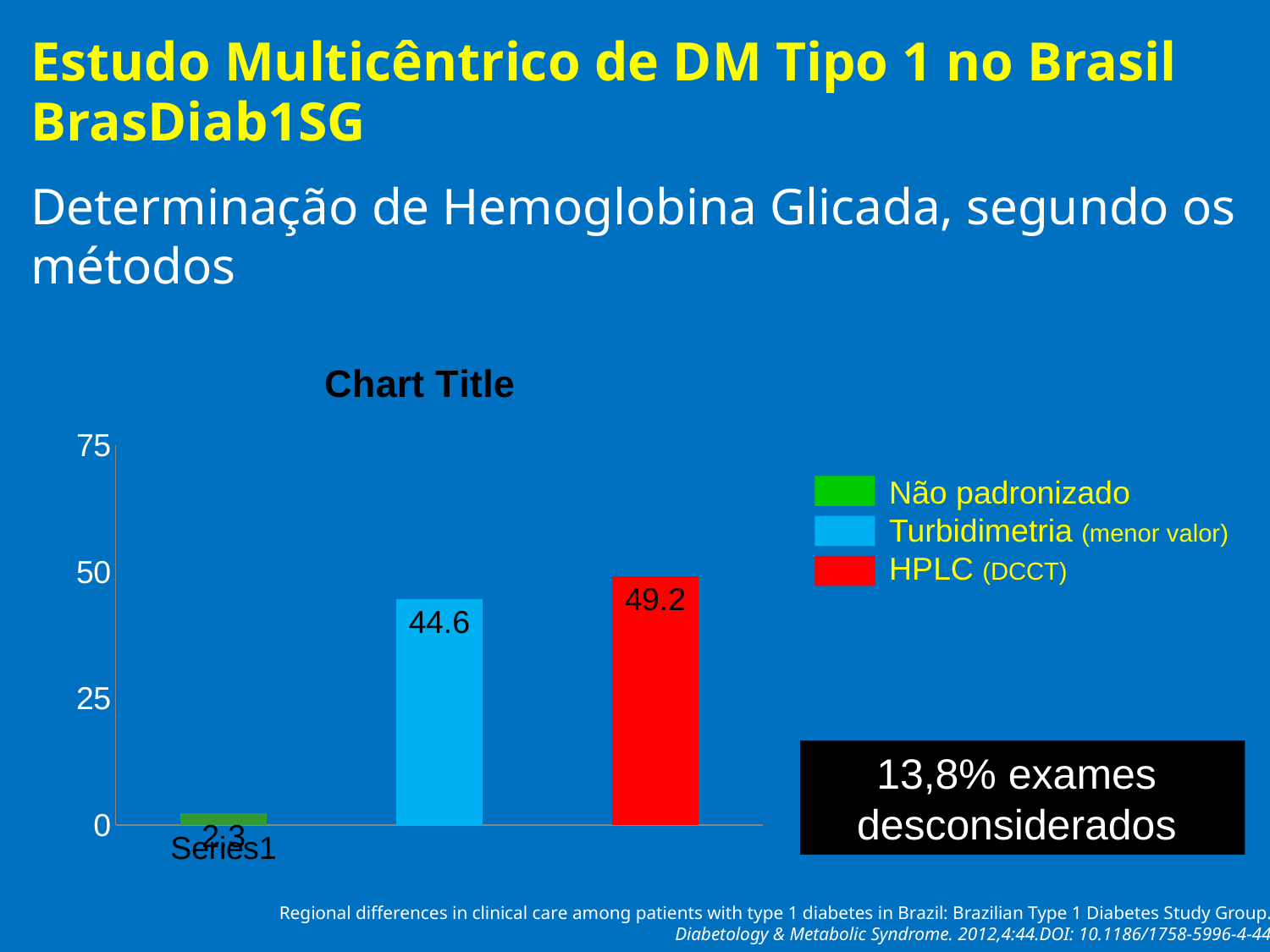
Is the value for HPLC (DCCT) greater or less than 50? less What colour is the bar for HPLC (DCCT)? red What is the difference between the HPLC (DCCT) value and the Turbidimetria (menor valor) value? 4.6 Which method has the highest value in the chart? HPLC (DCCT) Is the value for Turbidimetria (menor valor) greater or less than 25? greater What value is shown for Turbidimetria (menor valor)? 44.6 How many series does the legend list? 3 Which is larger, the value for Turbidimetria (menor valor) or the value for Não padronizado? Turbidimetria (menor valor) What value is shown for HPLC (DCCT)? 49.2 What kind of chart is shown on the slide? bar chart What value is shown for Não padronizado? 2.3 Which method has the lowest value in the chart? Não padronizado